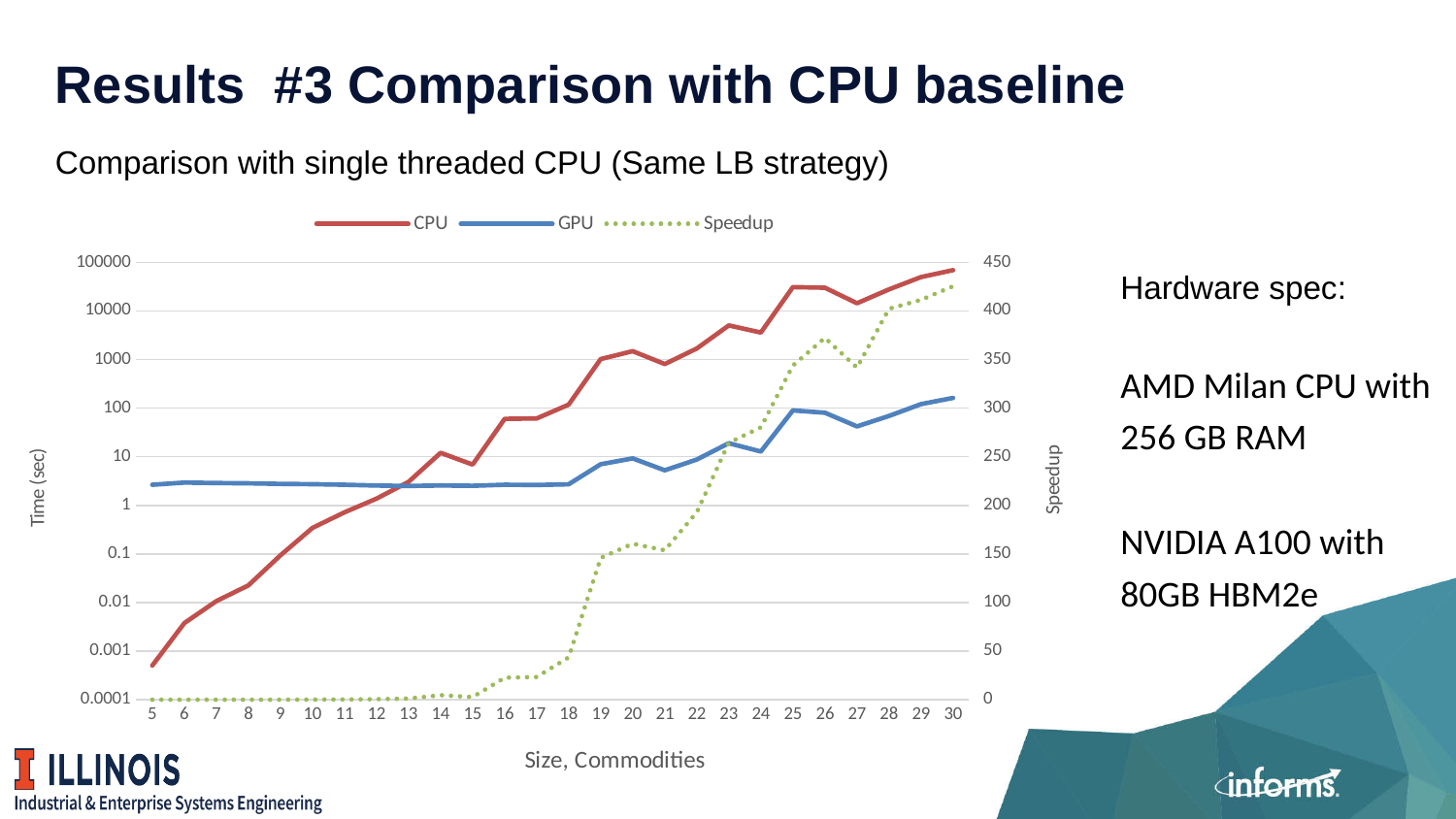
At size 30, which is larger, the CPU time or the GPU time? CPU Does the CPU time rise or fall as the size increases from 5 to 30? rises Which series in the chart is drawn with a dotted line? Speedup At size 5, which is larger, the CPU time or the GPU time? GPU Is the GPU time at size 30 greater or less than 100 seconds? greater What kind of chart is shown on the slide? line chart Is the CPU time at size 30 greater or less than 10000 seconds? greater How many size values are plotted along the x axis of the chart? 26 Is the Speedup value at size 15 greater or less than 50? less How many series does the chart legend list? 3 What is the title of the x axis of the chart? Size, Commodities